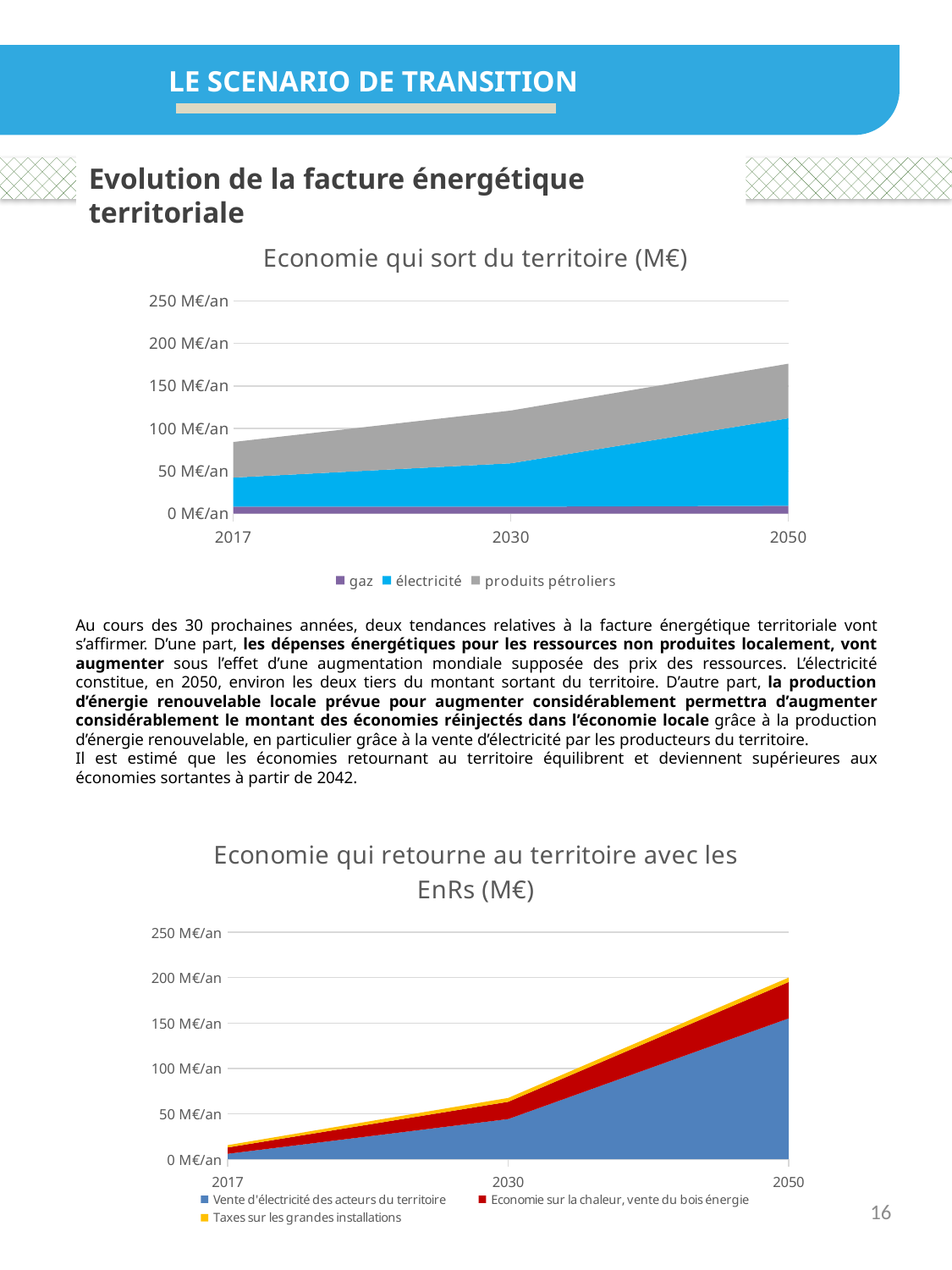
How many years are shown on the x axis of the 'Economie qui sort du territoire (M€)' chart? 3 How many series does the legend of the 'Economie qui retourne au territoire avec les EnRs (M€)' chart list? 3 In the 'Economie qui sort du territoire (M€)' chart, which series is shown in purple? gaz In the 'Economie qui sort du territoire (M€)' chart, is the total stacked value in 2050 greater or less than 150 M€/an? greater What kind of chart is the 'Economie qui sort du territoire (M€)' chart? stacked area chart In the 'Economie qui sort du territoire (M€)' chart, is the total stacked value in 2017 greater or less than 100 M€/an? less How many series does the legend of the 'Economie qui sort du territoire (M€)' chart list? 3 Which chart has the larger total stacked value in 2017, 'Economie qui sort du territoire (M€)' or 'Economie qui retourne au territoire avec les EnRs (M€)'? Economie qui sort du territoire (M€) In the 'Economie qui retourne au territoire avec les EnRs (M€)' chart, is the total stacked value in 2017 greater or less than 50 M€/an? less In the 'Economie qui sort du territoire (M€)' chart, does the total stacked value rise or fall from 2017 to 2050? rise In the 'Economie qui retourne au territoire avec les EnRs (M€)' chart, which year has the highest total stacked value? 2050